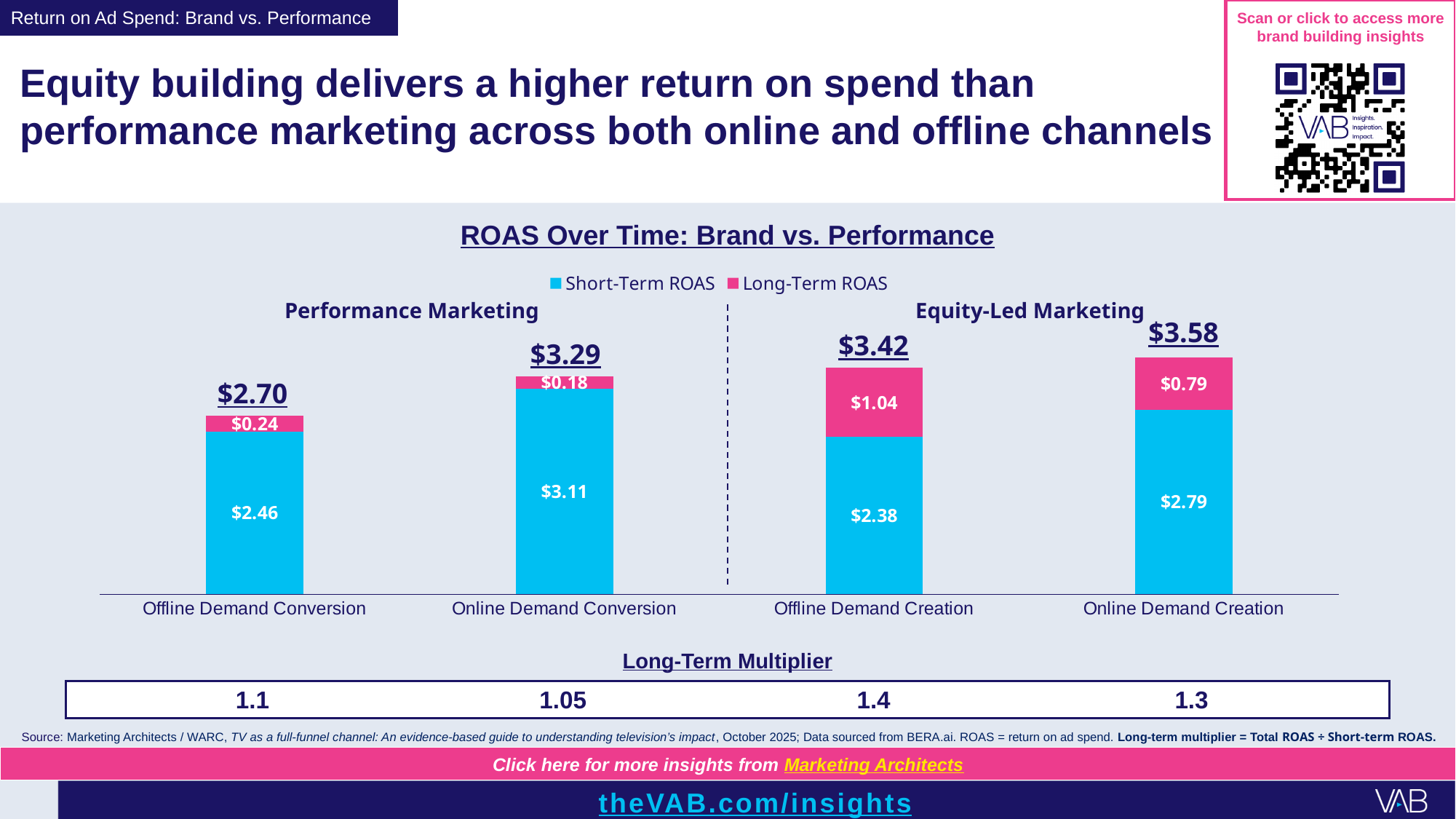
What is the Long-Term ROAS for Online Demand Conversion? $0.18 What kind of chart is shown? Stacked bar chart How many series does the legend list? 2 How many categories are shown on the x axis? 4 What is the Short-Term ROAS for Offline Demand Conversion? $2.46 Which is larger, the Short-Term ROAS for Online Demand Conversion or for Offline Demand Creation? Online Demand Conversion What is the Long-Term ROAS for Offline Demand Creation? $1.04 What is the difference between the total ROAS for Online Demand Creation and Online Demand Conversion? $0.29 What is the total ROAS for Offline Demand Creation? $3.42 What is the Short-Term ROAS for Online Demand Creation? $2.79 Which category has the highest total ROAS? Online Demand Creation Which category has the lowest total ROAS? Offline Demand Conversion